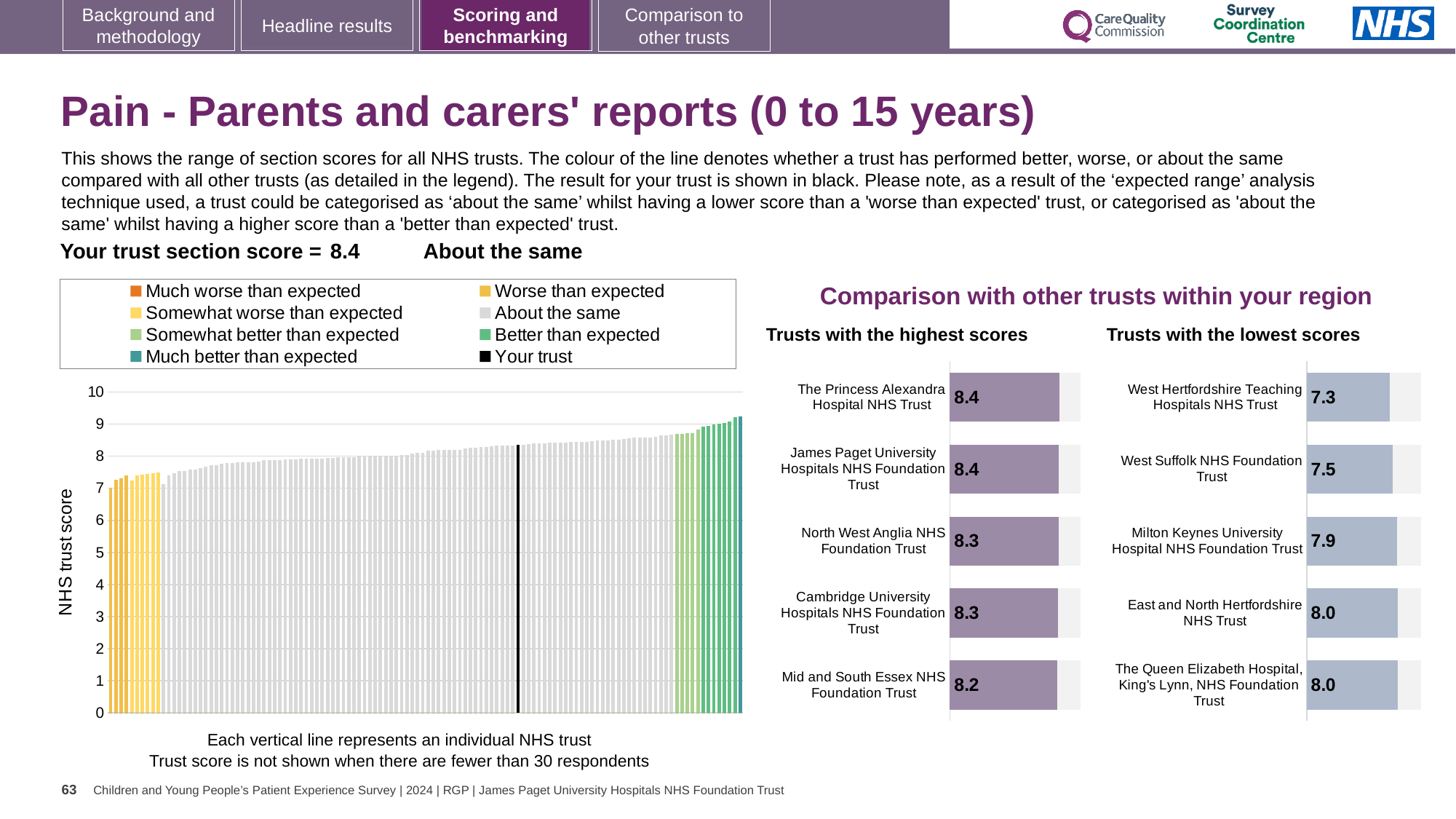
In the 'Trusts with the lowest scores' chart, which has the larger score: West Suffolk NHS Foundation Trust or East and North Hertfordshire NHS Trust? East and North Hertfordshire NHS Trust In the large chart on the left, what is the label on the y-axis? NHS trust score In the 'Trusts with the lowest scores' chart, what is the difference between the scores of West Suffolk NHS Foundation Trust and West Hertfordshire Teaching Hospitals NHS Trust? 0.2 In the 'Trusts with the highest scores' chart, how many trusts are shown? 5 In the 'Trusts with the lowest scores' chart, what is the score for Milton Keynes University Hospital NHS Foundation Trust? 7.9 In the 'Trusts with the highest scores' chart, what is the score for Mid and South Essex NHS Foundation Trust? 8.2 In the large chart on the left, do the bar values rise or fall from left to right? rise How many entries does the legend above the large chart on the left list? 8 What kind of chart is the large chart on the left with the y-axis labelled 'NHS trust score'? bar chart In the large chart on the left, is the value of the black bar (your trust) greater or less than 8? greater In the 'Trusts with the highest scores' chart, what is the score for North West Anglia NHS Foundation Trust? 8.3 In the 'Trusts with the lowest scores' chart, which trust has the lowest score? West Hertfordshire Teaching Hospitals NHS Trust